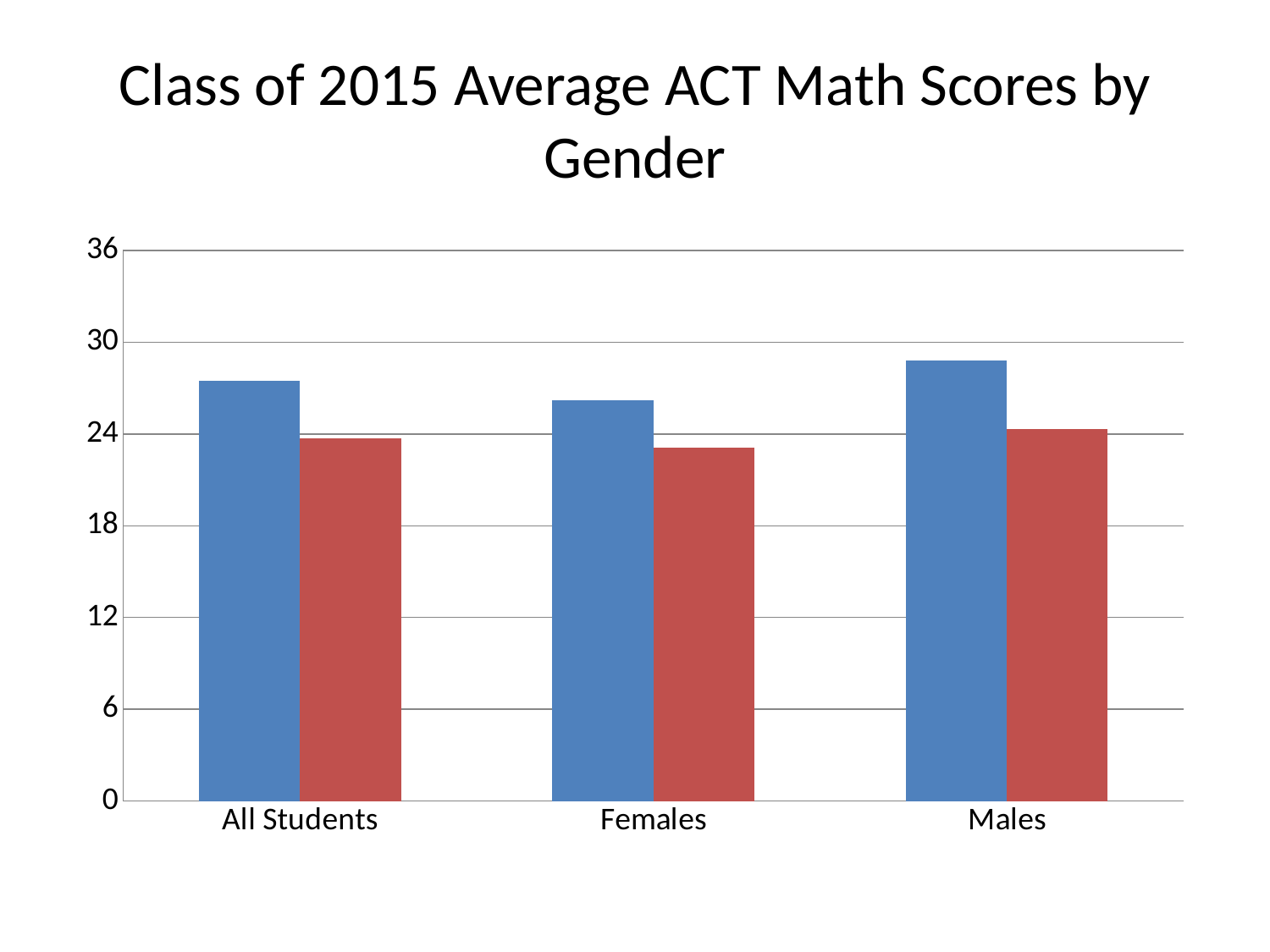
Is the red bar for Females greater or less than 24? less Which category has the shortest blue bar? Females Which category has the tallest blue bar? Males Which category has the shortest red bar? Females How many bars are plotted for each category on the chart? 2 Is the blue bar for Males greater or less than 30? less What is the title of the chart? Class of 2015 Average ACT Math Scores by Gender For Females, which bar is taller, the blue bar or the red bar? the blue bar How many categories are shown on the x axis of the chart? 3 Which is taller, the blue bar for Males or the blue bar for Females? the blue bar for Males What kind of chart is shown on the slide? bar chart Is the blue bar for All Students greater or less than 24? greater